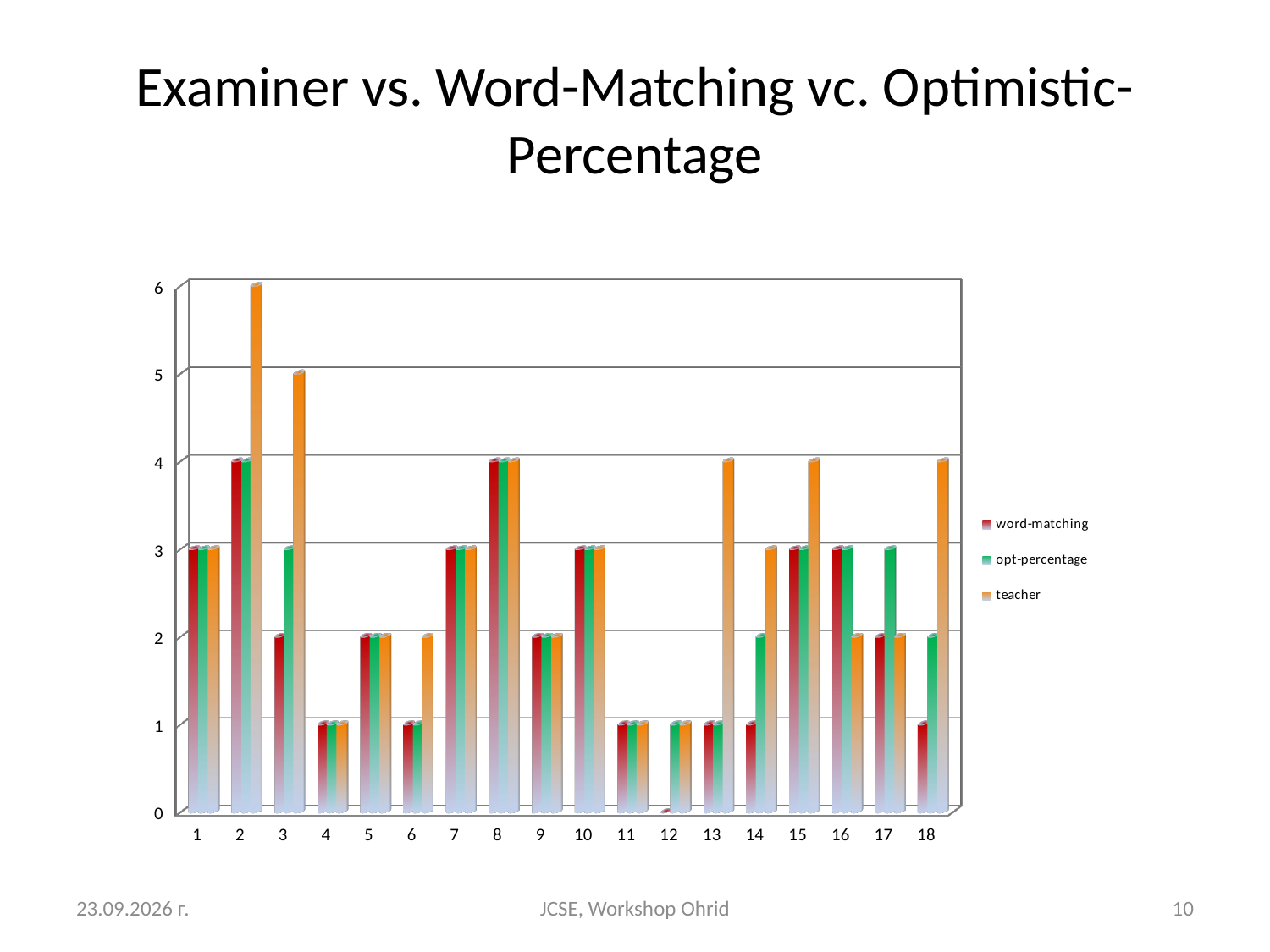
For which category is the teacher value highest? 2 How many categories are shown on the x axis? 18 How many series does the legend list? 3 For category 13, which is larger: the teacher value or the word-matching value? teacher What is the teacher value for category 3? 5 What is the word-matching value for category 8? 4 Which series is shown in orange in the legend? teacher What is the teacher value for category 2? 6 For which category is the word-matching value lowest? 12 What kind of chart is shown on the slide? bar chart Is the teacher value for category 2 greater or less than 5? greater What is the difference between the teacher value and the word-matching value for category 2? 2